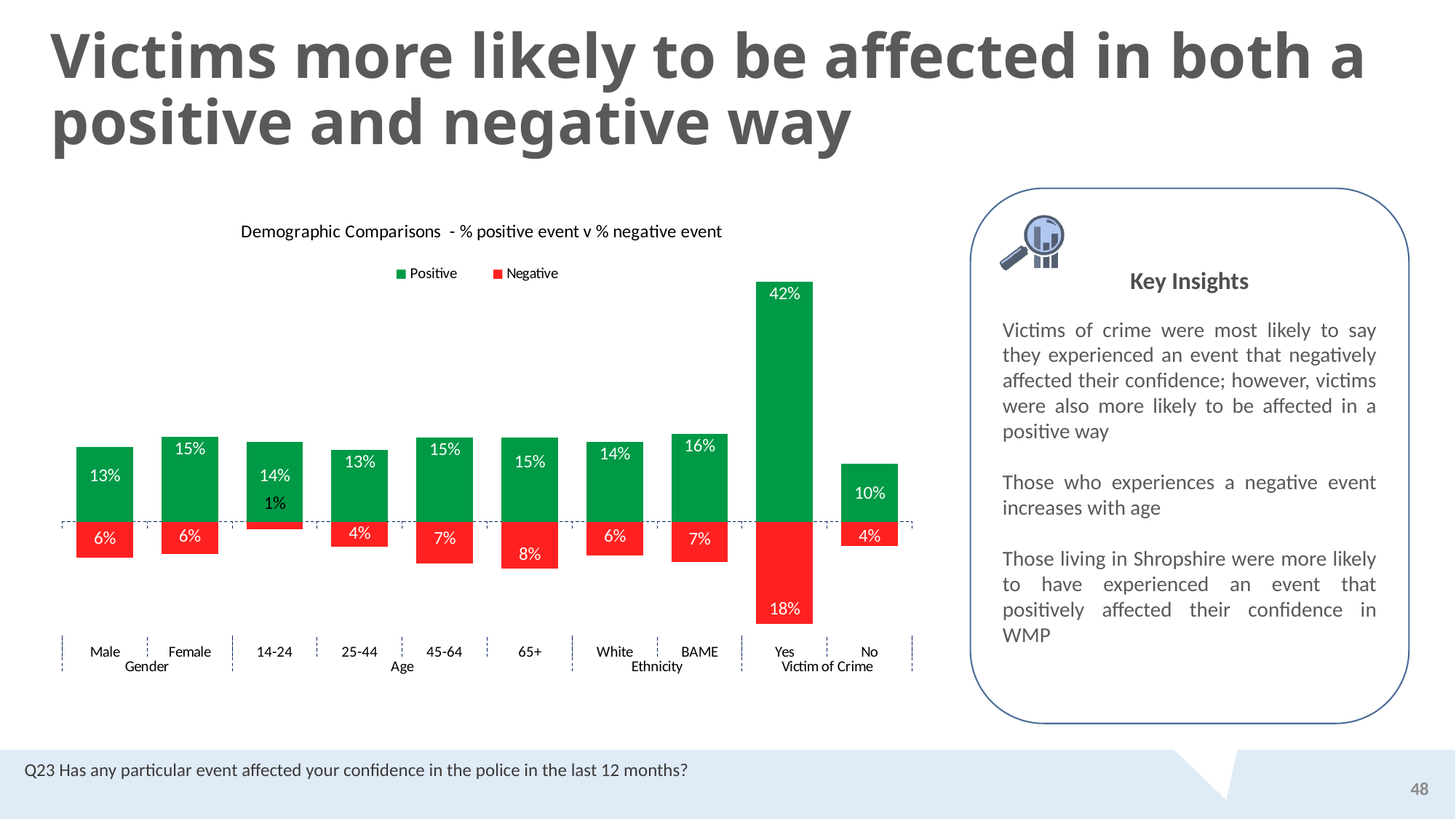
What is the difference between the Positive values for Yes and No under Victim of Crime? 32% How many series does the legend list? 2 How many categories are shown on the x axis? 10 Does the Negative value rise or fall across the age groups from 14-24 to 65+? Rises What kind of chart is shown on the slide? Stacked bar chart Which category has the lowest Negative value? 14-24 What is the Negative value for the 14-24 age group? 1% What is the Negative value for the 65+ age group? 8% Which category has the highest Positive value? Yes (Victim of Crime) What is the Positive value for the Yes (Victim of Crime) category? 42% What is the Positive value for BAME? 16% Which is larger, the Negative value for White or the Negative value for BAME? BAME